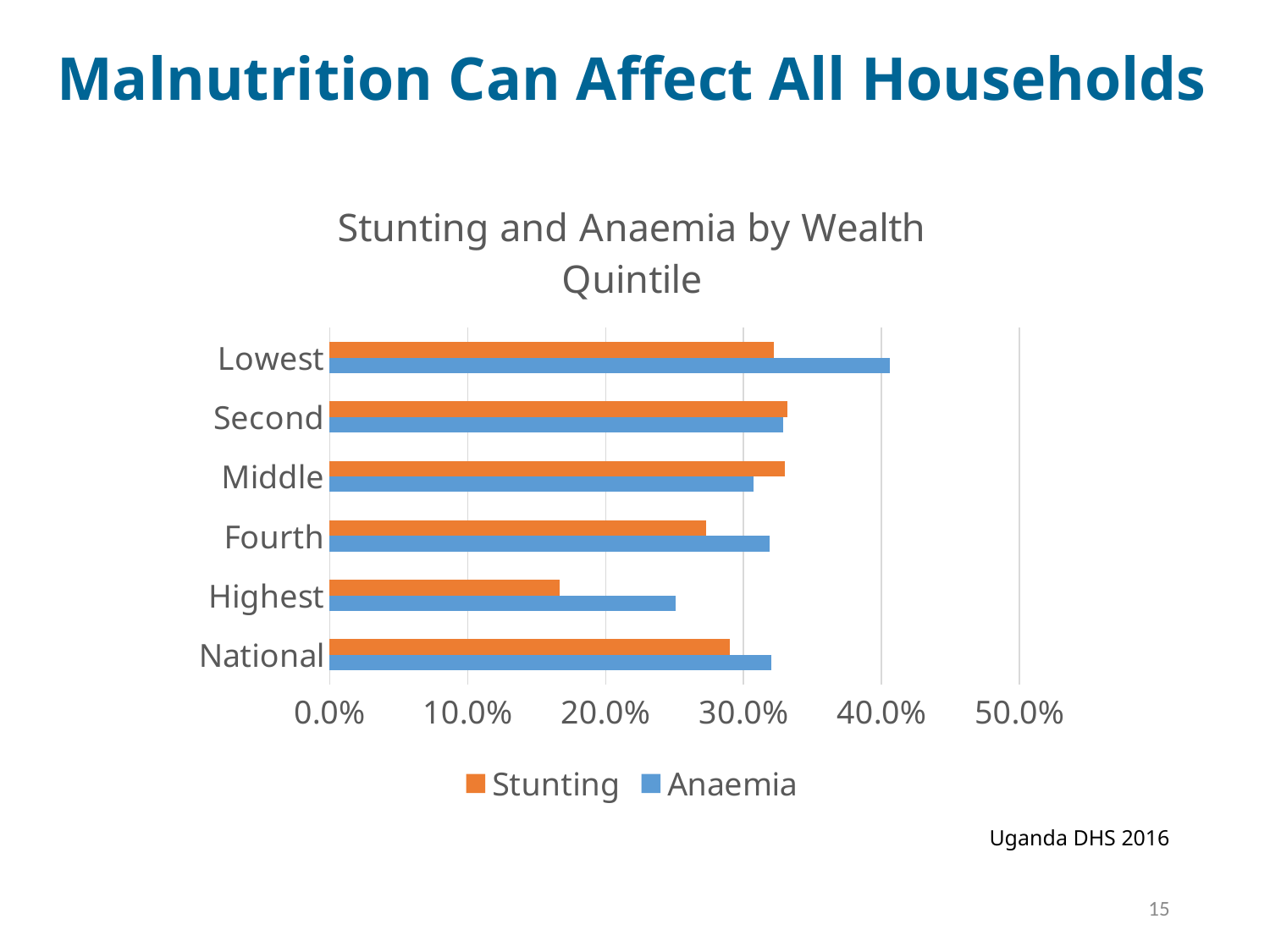
What kind of chart is shown on the slide? Bar chart For the Lowest wealth quintile, which is larger: Stunting or Anaemia? Anaemia What is the title of the chart? Stunting and Anaemia by Wealth Quintile Which category has the highest Anaemia value? Lowest Which category has the lowest Stunting value? Highest Which category has the lowest Anaemia value? Highest How many series does the legend list? 2 How many categories are shown on the vertical axis of the chart? 6 Is the Stunting value for the Highest quintile greater or less than 20.0%? less Is the Stunting value for the Fourth quintile greater or less than 30.0%? less For the Highest wealth quintile, which is larger: Stunting or Anaemia? Anaemia